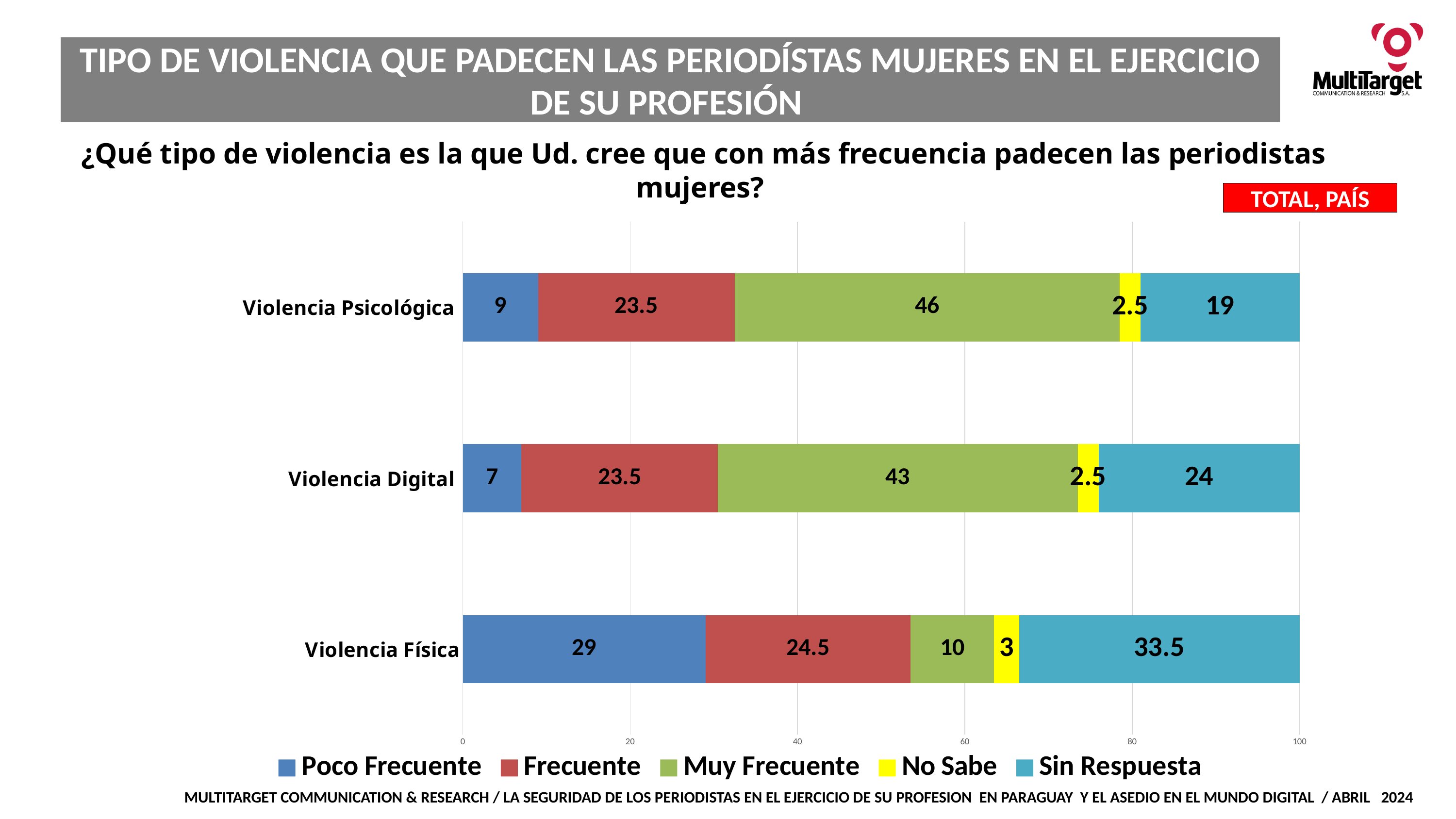
What is the value for Muy Frecuente for Violencia Psicológica? 46 Which colour represents No Sabe in the legend? Yellow Which category has the lowest Muy Frecuente value? Violencia Física How many categories are shown on the chart? 3 Which category has the highest Poco Frecuente value? Violencia Física How many series does the legend list? 5 Which is larger: Sin Respuesta for Violencia Digital or Sin Respuesta for Violencia Psicológica? Violencia Digital What kind of chart is shown on the slide? Stacked bar chart What is the total of the stacked bar for Violencia Física? 100 What is the value for Sin Respuesta for Violencia Física? 33.5 What is the value for Poco Frecuente for Violencia Digital? 7 What is the difference between the Muy Frecuente values for Violencia Psicológica and Violencia Digital? 3